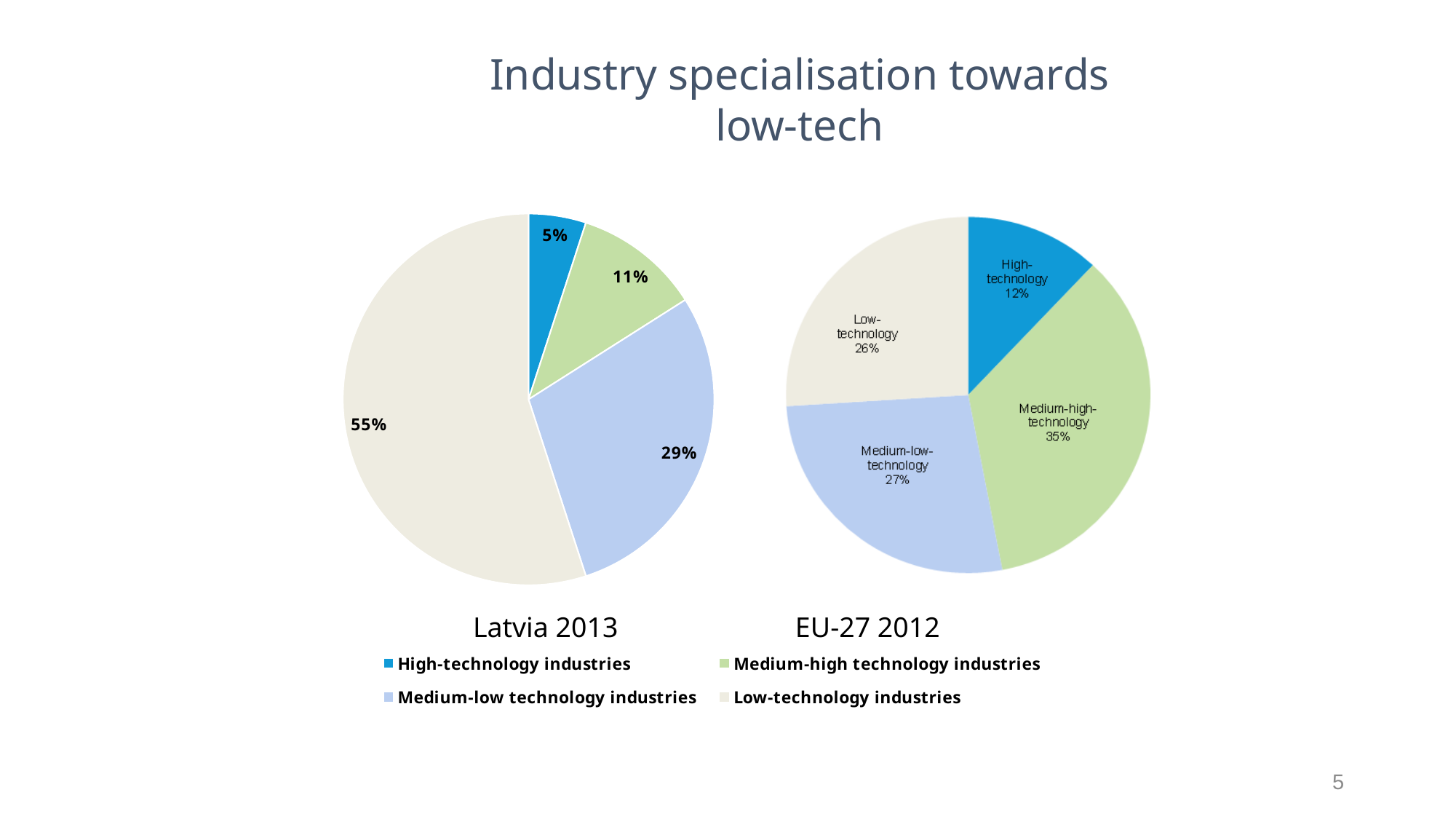
In the EU-27 2012 pie chart, what share does Low-technology have? 26% What colour represents Medium-low technology industries in the legend? Light blue How many slices does the Latvia 2013 pie chart have? 4 In the Latvia 2013 pie chart, what share do Low-technology industries have? 55% In the Latvia 2013 pie chart, what share do High-technology industries have? 5% Which is larger: the High-technology share in the Latvia 2013 chart or in the EU-27 2012 chart? EU-27 2012 In the EU-27 2012 pie chart, which category has the smallest share? High-technology In the EU-27 2012 pie chart, what is the difference between the Medium-high-technology and High-technology shares? 23% In the EU-27 2012 pie chart, what share does Medium-high-technology have? 35% What type of chart is used for EU-27 2012? Pie chart In the Latvia 2013 pie chart, which category has the largest share? Low-technology industries In the Latvia 2013 pie chart, what is the difference between the Low-technology and Medium-low technology shares? 26%